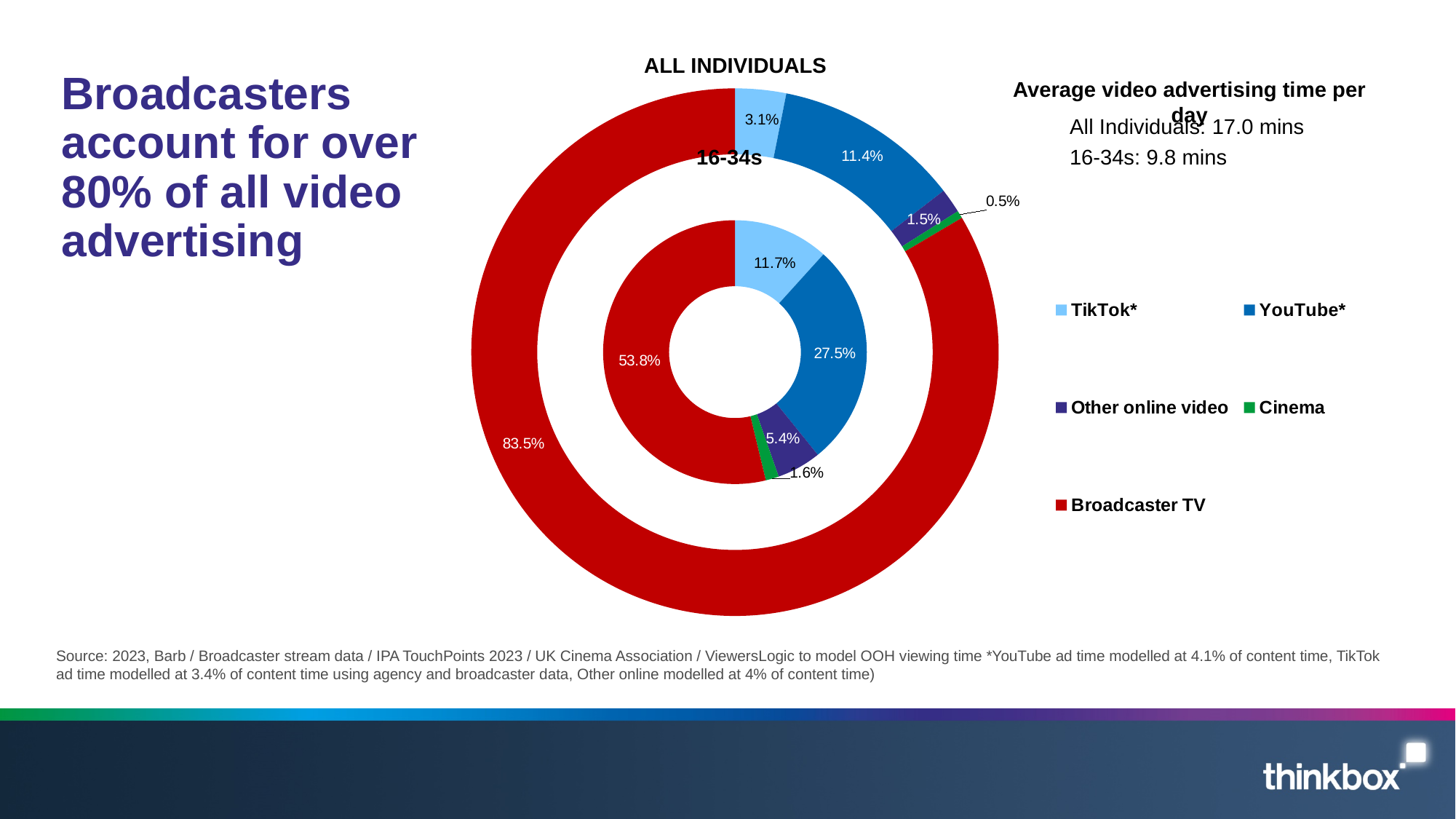
Which category has the largest share in the 16-34s ring? Broadcaster TV How many categories does the legend list? 5 What colour represents Broadcaster TV in the chart? Red Which category has the smallest share in the ALL INDIVIDUALS ring? Cinema What type of chart is shown on the slide? Doughnut chart What share of video advertising time does Broadcaster TV account for in the ALL INDIVIDUALS ring? 83.5% What is the Cinema share in the 16-34s ring? 1.6% What is the difference between the Broadcaster TV share for ALL INDIVIDUALS and for 16-34s? 29.7 percentage points What is the TikTok* share in the ALL INDIVIDUALS ring? 3.1% What share of video advertising time does YouTube* account for in the 16-34s ring? 27.5% Which is larger: the TikTok* share for 16-34s or the YouTube* share for ALL INDIVIDUALS? TikTok* share for 16-34s How many rings (series) does the doughnut chart show? 2